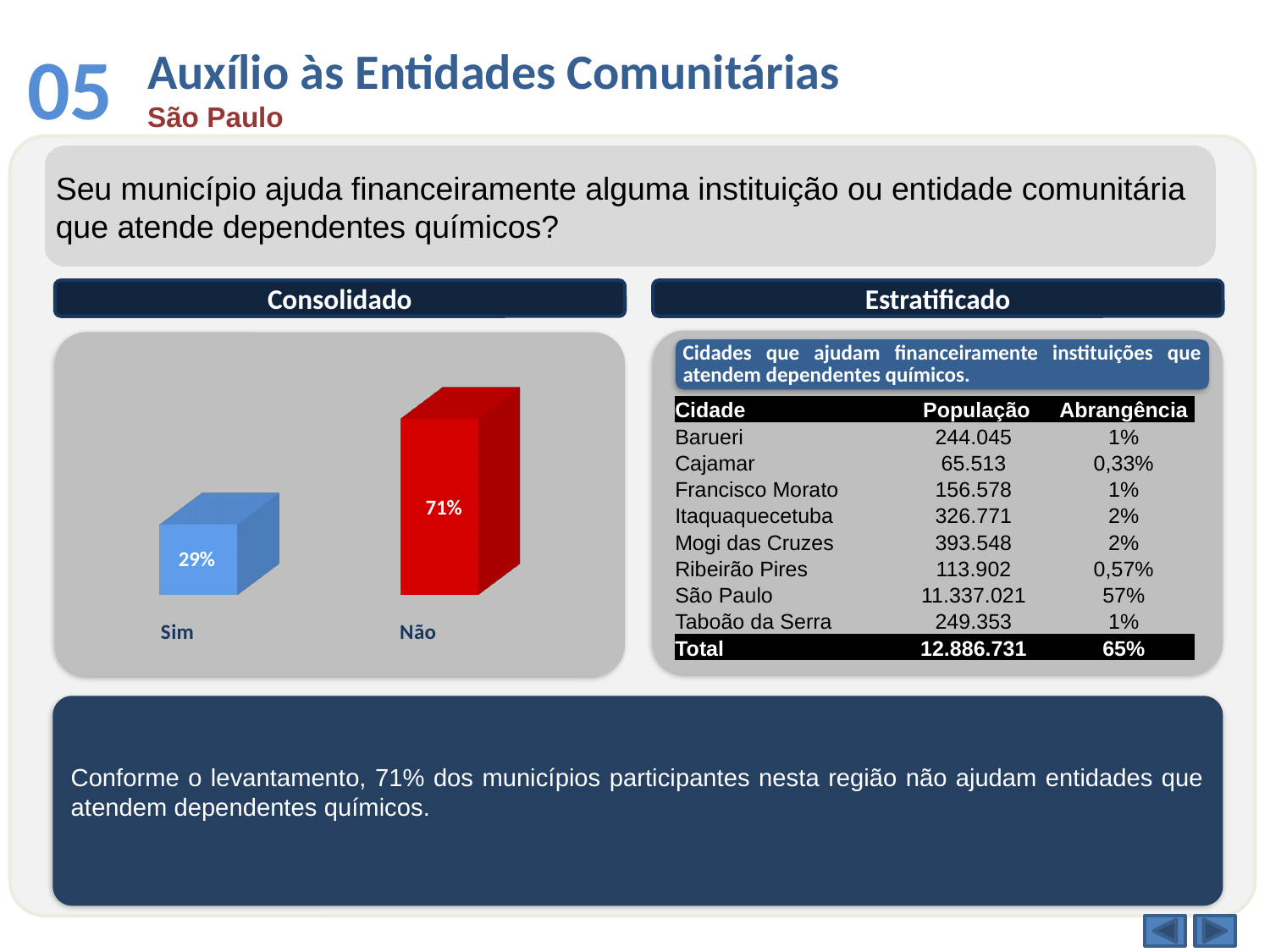
Which category has the lowest value in the Consolidado bar chart? Sim In the Consolidado bar chart, which is larger: the value for "Sim" or the value for "Não"? Não What is the value for "Não" in the Consolidado bar chart? 71% What is the difference between the values for "Não" and "Sim" in the Consolidado bar chart? 42 percentage points What colour is the "Sim" bar in the Consolidado bar chart? Blue What colour is the "Não" bar in the Consolidado bar chart? Red Which category has the highest value in the Consolidado bar chart? Não What type of chart is shown under the "Consolidado" heading? Bar chart What is the value for "Sim" in the Consolidado bar chart? 29% How many categories are shown in the Consolidado bar chart? 2